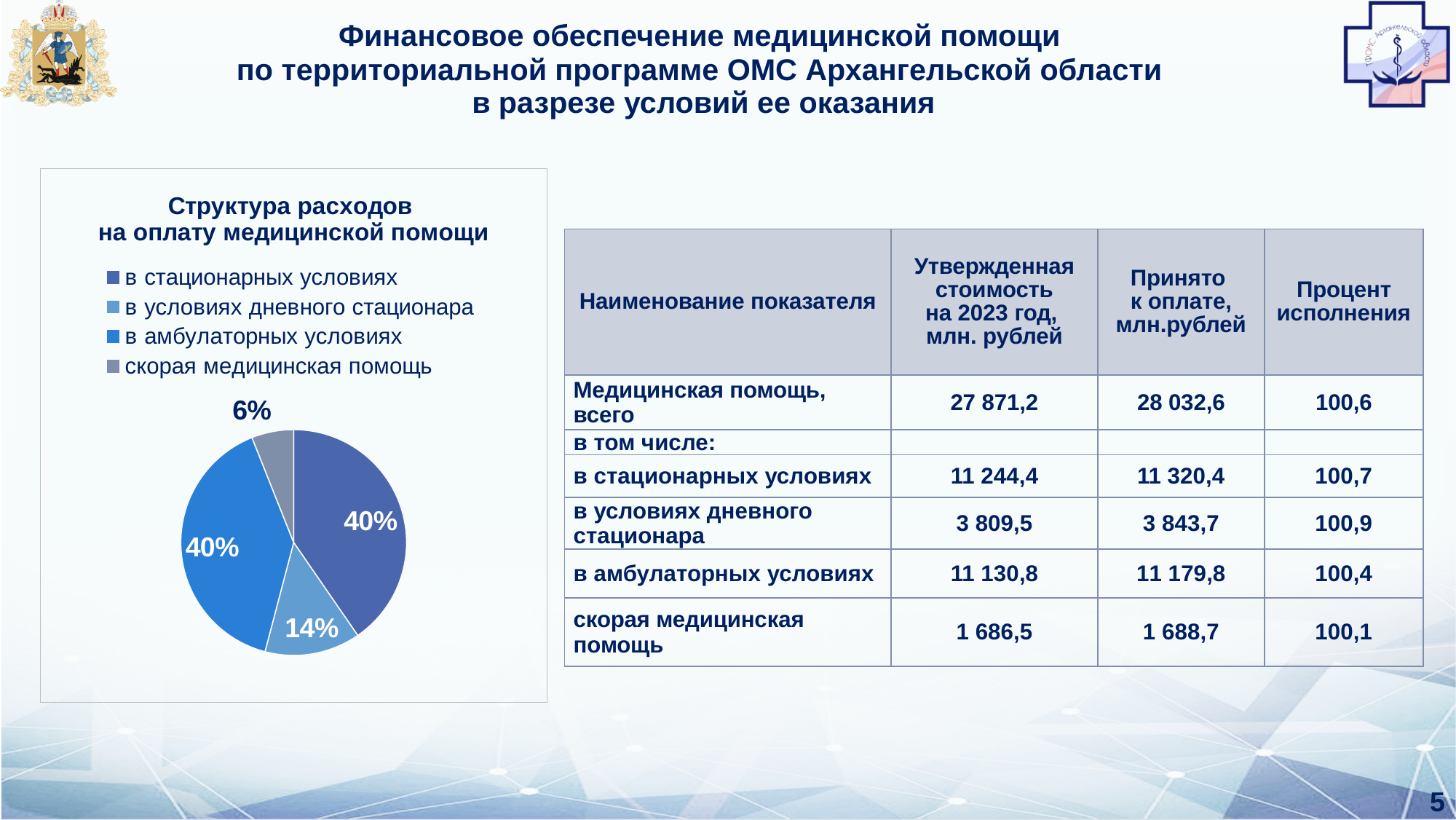
How many entries does the pie chart's legend list? 4 Which category has the smallest slice in the pie chart? скорая медицинская помощь Which is larger in the pie chart: "в условиях дневного стационара" or "скорая медицинская помощь"? в условиях дневного стационара How many slices does the pie chart have? 4 What share of the pie chart does "в условиях дневного стационара" have? 14% What is the title of the pie chart? Структура расходов на оплату медицинской помощи What share of the pie chart does "в амбулаторных условиях" have? 40% What share of the pie chart does "в стационарных условиях" have? 40% By how many percentage points does "в условиях дневного стационара" exceed "скорая медицинская помощь" in the pie chart? 8 Which category is shown in gray in the pie chart? скорая медицинская помощь What share of the pie chart does "скорая медицинская помощь" have? 6% What kind of chart is shown on the slide? pie chart